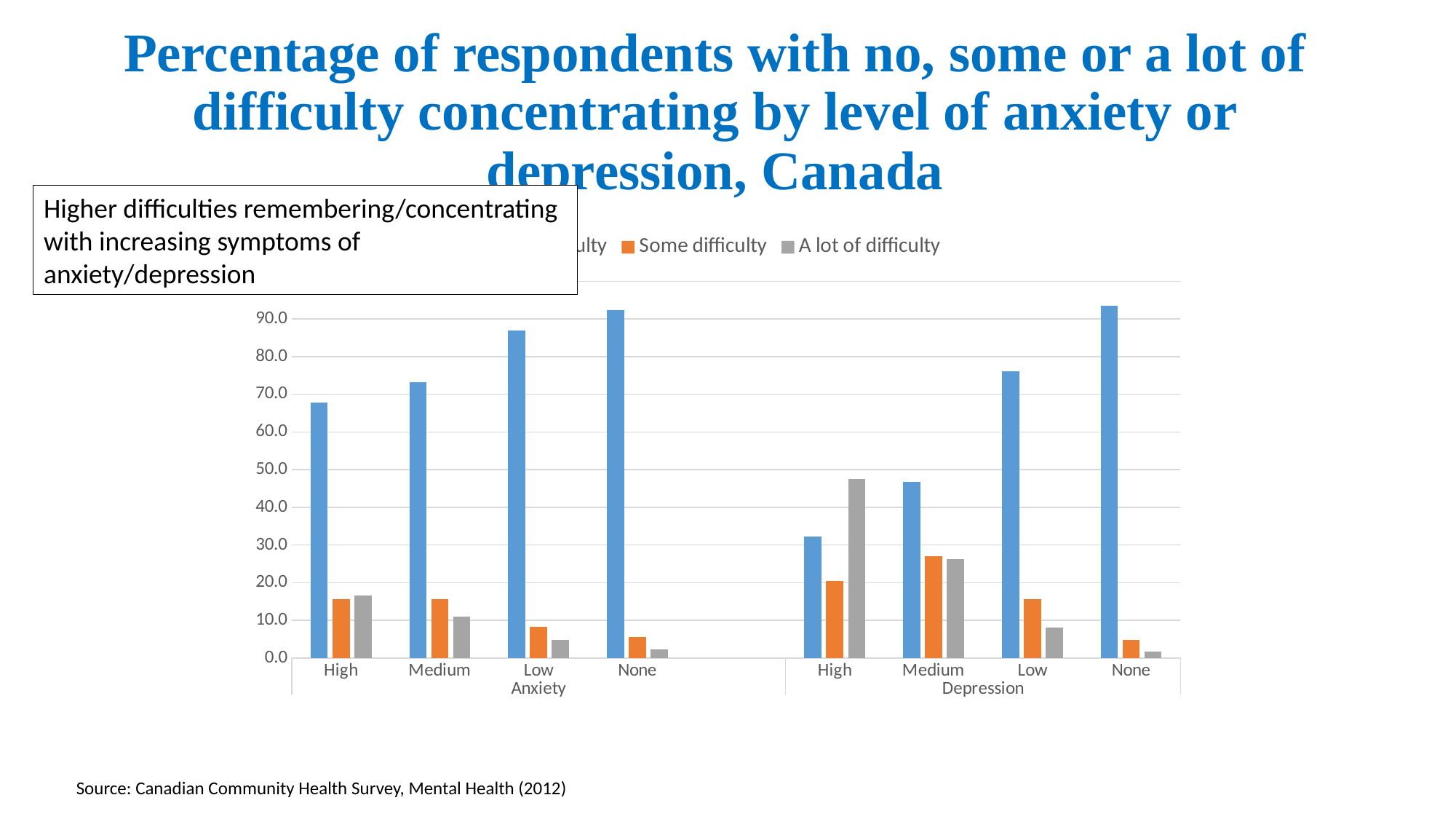
What kind of chart is shown on the slide? bar chart Is the 'Some difficulty' value for Medium under Depression greater or less than 20? greater What colour represents the 'Some difficulty' series? orange What source is cited for the chart's data? Canadian Community Health Survey, Mental Health (2012) Which category has the highest 'A lot of difficulty' bar? High (Depression) Is the 'A lot of difficulty' value for High under Depression greater or less than 40? greater Which is larger: the 'A lot of difficulty' value for High under Depression or for High under Anxiety? High under Depression How many series does the chart's legend list? 3 Is the 'A lot of difficulty' value for None under Anxiety greater or less than 10? less How many anxiety/depression level categories are plotted along the x axis in total? 8 Within the Anxiety group, do the 'Some difficulty' values rise or fall from High to None? fall